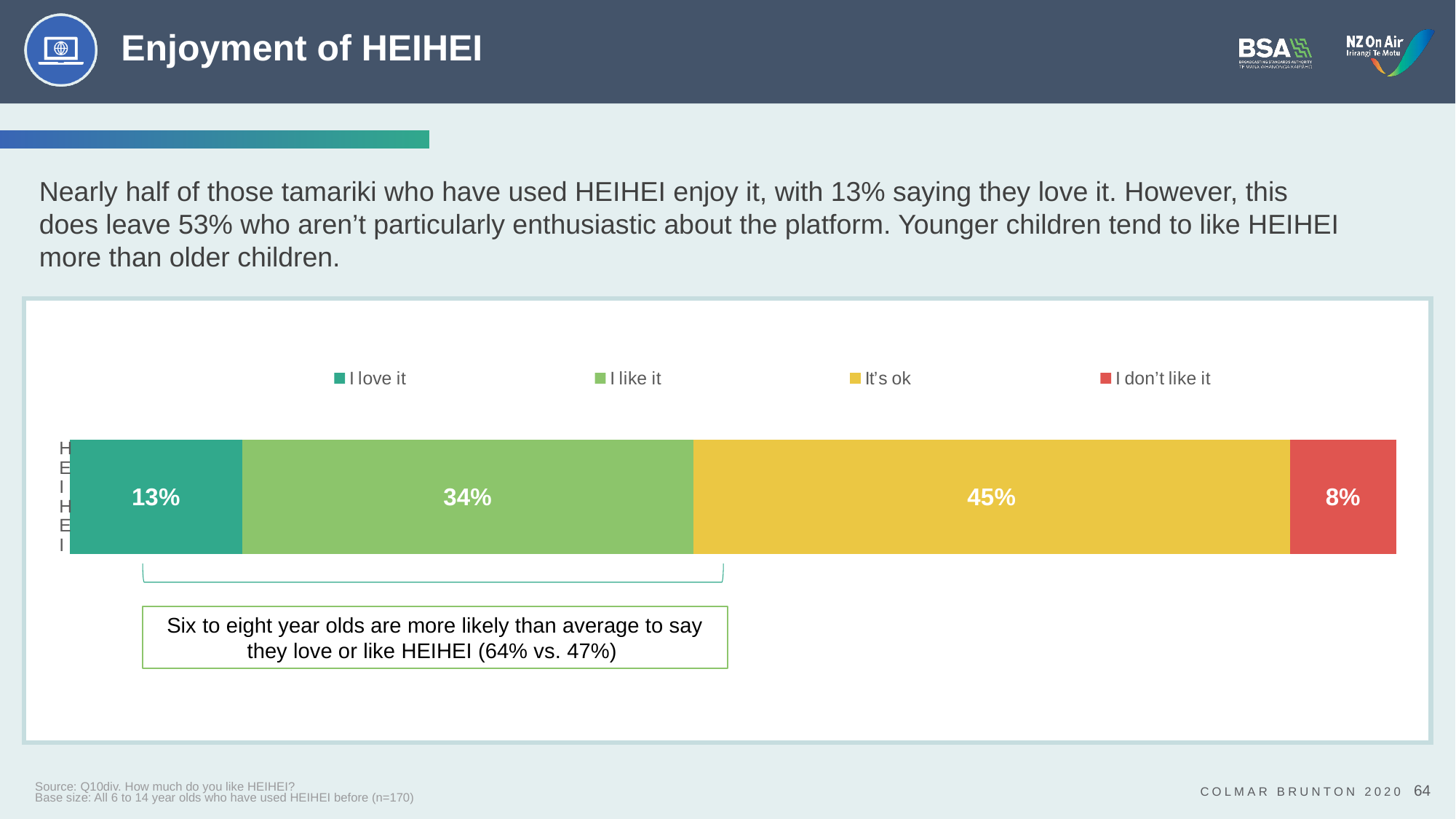
What kind of chart is shown on the slide? Stacked bar chart What percentage of tamariki say HEIHEI is ok? 45% What colour is the 'I don't like it' segment? Red What is the difference between the 'It's ok' and 'I like it' percentages? 11 percentage points Which is larger, the 'I love it' share or the 'I don't like it' share? I love it What is the total of the 'I love it' and 'I like it' segments combined? 47% What percentage of tamariki say they don't like HEIHEI? 8% Which response has the largest share of the HEIHEI bar? It's ok What percentage of tamariki say they like HEIHEI? 34% How many series does the legend list? 4 What percentage of tamariki say they love HEIHEI? 13% Which response has the smallest share of the HEIHEI bar? I don't like it